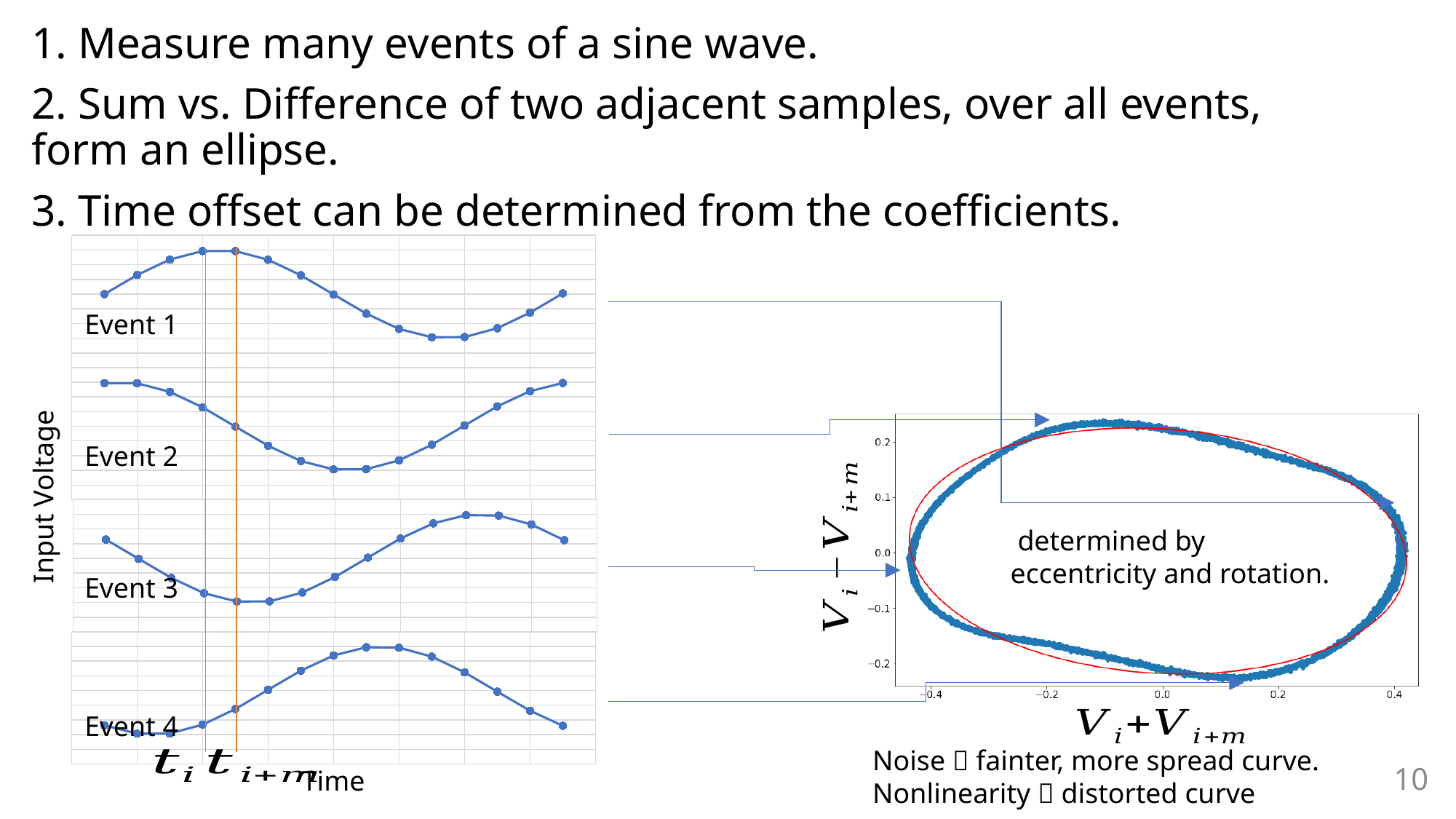
In the left chart, does the Event 4 curve initially rise or fall from its first point? fall In the right chart, is the lowest value reached by the blue curve on the vertical axis greater or less than -0.2? less How many events are plotted in the left chart? 4 What is the y-axis label of the left chart? Input Voltage What kind of chart is the right chart with the ellipse? scatter chart In the right chart, what is the largest tick value shown on the horizontal axis? 0.4 What is the x-axis label of the left chart? Time In the left chart, which event's curve is plotted lowest on the chart? Event 4 In the right chart, is the highest value reached by the blue curve on the vertical axis greater or less than 0.2? greater In the left chart, does the Event 2 curve initially fall or rise from its first point? fall In the left chart, which event's curve is plotted highest on the chart? Event 1 What kind of chart is the left chart showing Event 1 through Event 4? line chart